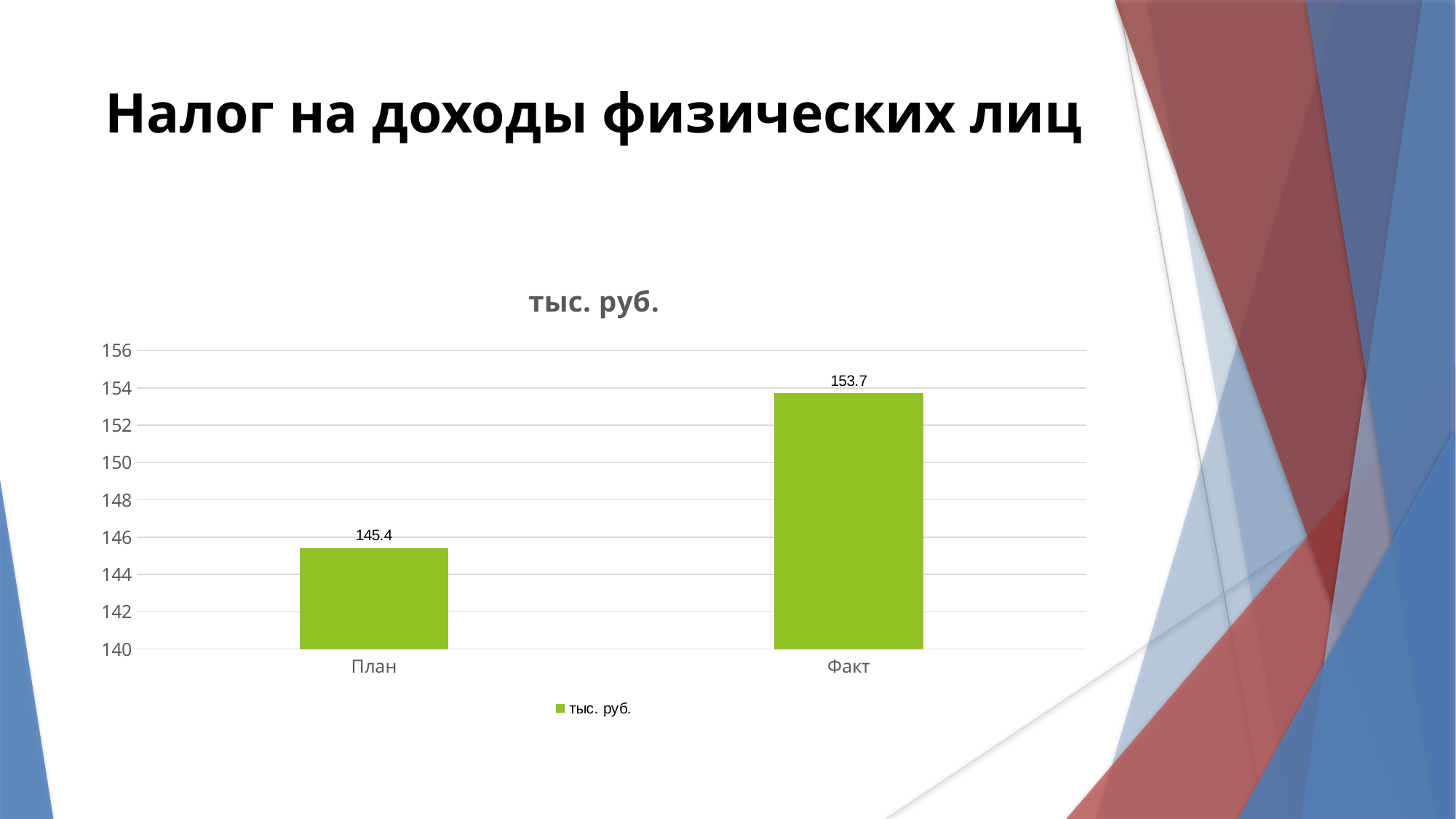
What kind of chart is shown on the slide? bar chart What is the difference between the values for Факт and План? 8.3 How many series does the legend list? 1 Is the value for План greater or less than 150? less How many categories are shown on the x axis? 2 Which category has the highest value? Факт What is the value for Факт? 153.7 Is the value for Факт greater or less than 150? greater Which category has the lowest value? План Which is larger, the value for План or the value for Факт? Факт What is the value for План? 145.4 What is the title of the chart? тыс. руб.